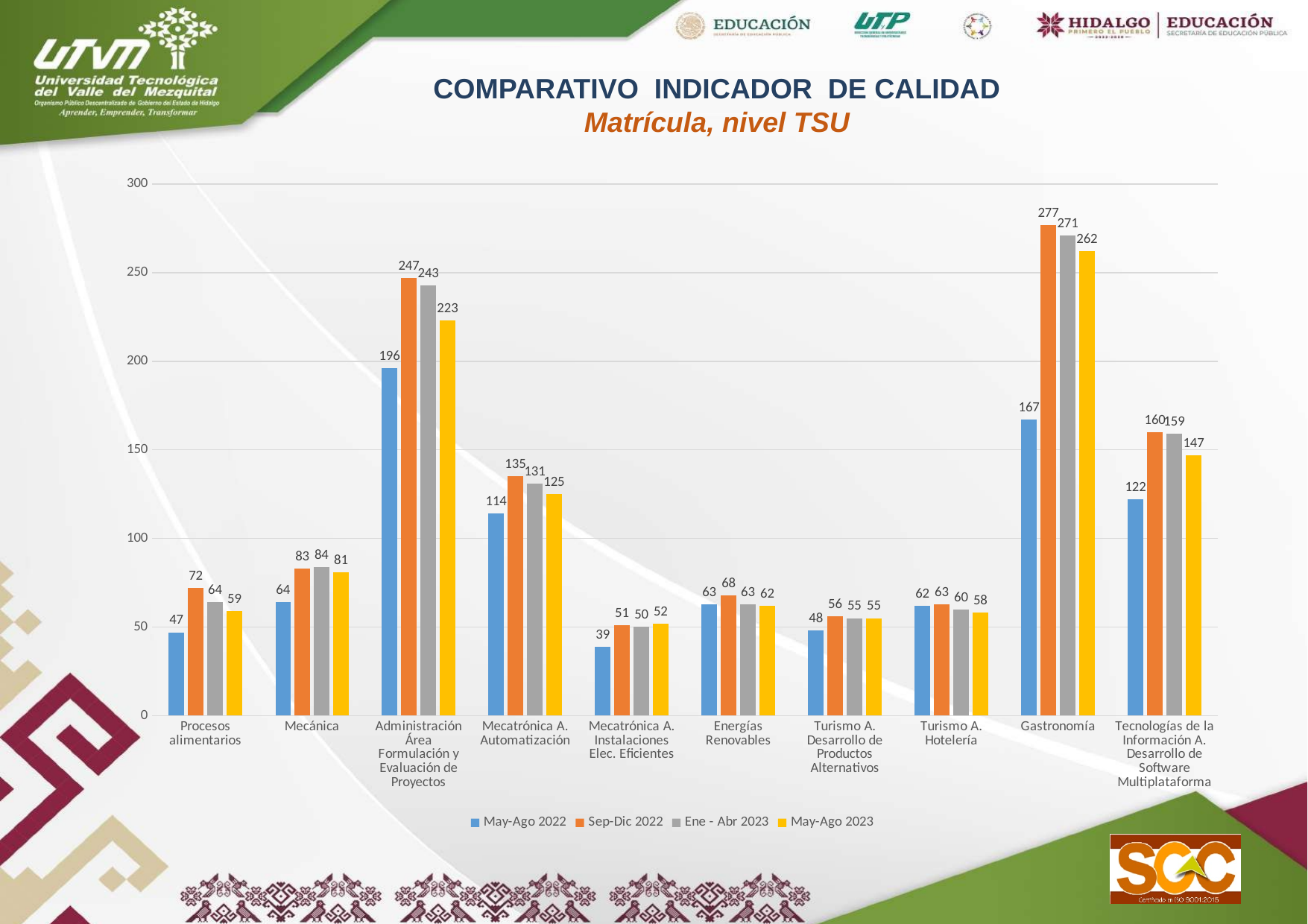
Which category has the highest value in the Sep-Dic 2022 series? Gastronomía Is the Ene - Abr 2023 value for Administración Área Formulación y Evaluación de Proyectos greater or less than 200? greater What is the difference between the Sep-Dic 2022 and May-Ago 2022 values for Gastronomía? 110 What is the value for Mecatrónica A. Instalaciones Elec. Eficientes in the May-Ago 2023 series? 52 How many categories (programs) are shown on the x axis? 10 What is the value for Gastronomía in the Sep-Dic 2022 series? 277 How many series does the legend list? 4 What type of chart is shown on the slide? Bar chart What is the subtitle of the chart shown in orange text? Matrícula, nivel TSU Which category has the lowest value in the May-Ago 2022 series? Mecatrónica A. Instalaciones Elec. Eficientes Which is larger for Procesos alimentarios: the Sep-Dic 2022 value or the May-Ago 2023 value? Sep-Dic 2022 What is the value for Mecánica in the May-Ago 2022 series? 64